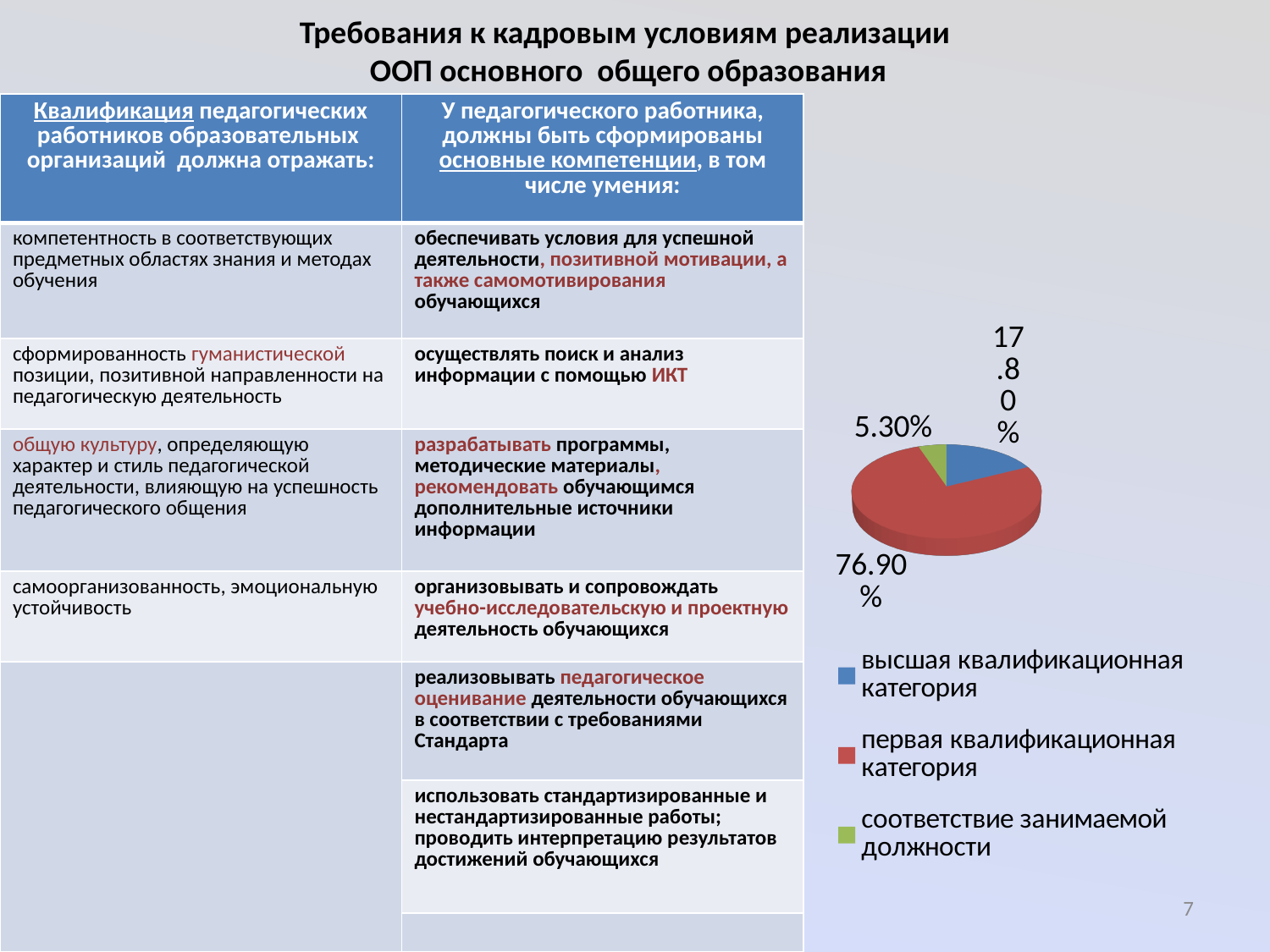
What colour is the slice for 'первая квалификационная категория'? red Which category has the smallest slice of the pie? соответствие занимаемой должности How many slices does the pie chart have? 3 What kind of chart is shown on the slide? pie chart What is the difference between the shares of 'первая квалификационная категория' and 'высшая квалификационная категория'? 59.10% What share of the pie does 'первая квалификационная категория' have? 76.90% Which is larger: the slice for 'высшая квалификационная категория' or the slice for 'соответствие занимаемой должности'? высшая квалификационная категория Which category has the largest slice of the pie? первая квалификационная категория How many entries does the legend of the pie chart list? 3 What colour is the slice for 'соответствие занимаемой должности'? green What share of the pie does 'соответствие занимаемой должности' have? 5.30% What share of the pie does 'высшая квалификационная категория' have? 17.80%